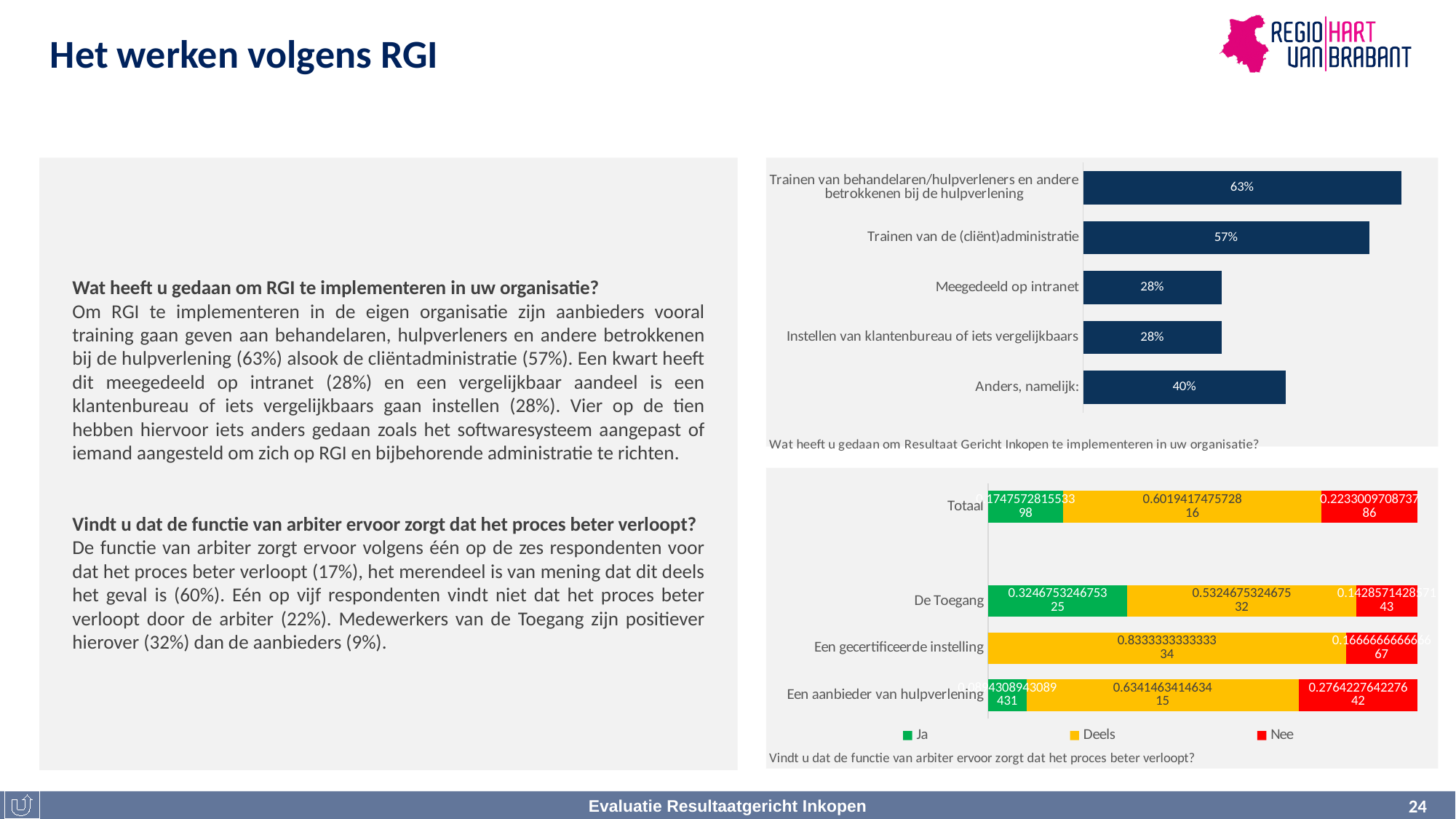
What are the legend entries of the bottom chart? Ja, Deels, Nee In the top chart, which is larger: the value for 'Anders, namelijk:' or the value for 'Meegedeeld op intranet'? Anders, namelijk: How many categories are shown in the bottom chart? 4 What kind of chart is the top chart? Bar chart In the bottom chart, which series has the largest share for 'Een gecertificeerde instelling'? Deels In the top chart, what is the difference between the values for 'Trainen van behandelaren/hulpverleners en andere betrokkenen bij de hulpverlening' and 'Trainen van de (cliënt)administratie'? 6% How many series does the legend of the bottom chart list? 3 In the top chart, what is the value for 'Instellen van klantenbureau of iets vergelijkbaars'? 28% In the top chart, what is the value for 'Anders, namelijk:'? 40% In the top chart, what is the value for 'Trainen van de (cliënt)administratie'? 57% In the top chart, which category has the highest value? Trainen van behandelaren/hulpverleners en andere betrokkenen bij de hulpverlening How many categories are shown in the top chart? 5